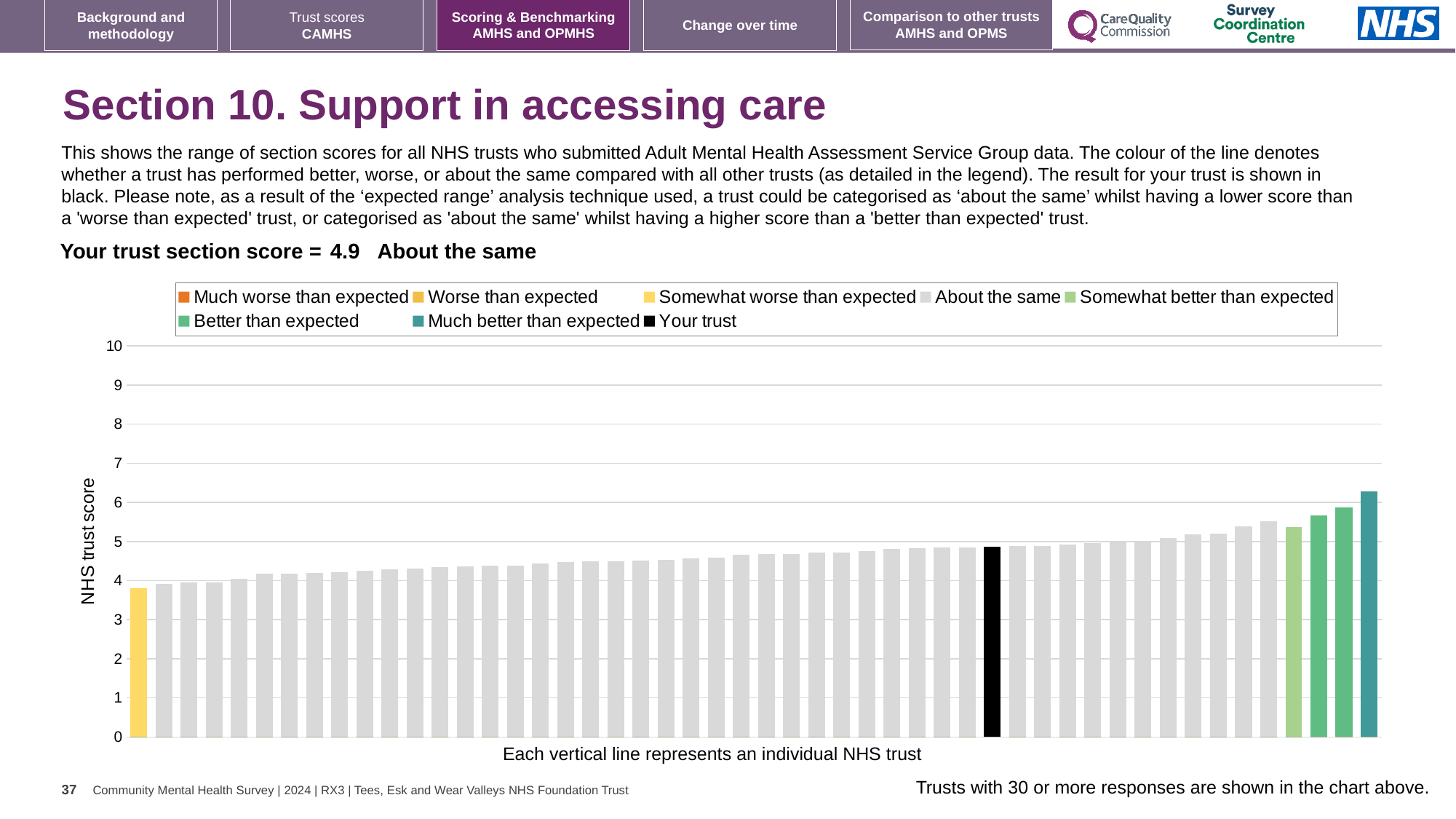
What kind of chart is shown on the slide? bar chart What is the label on the vertical axis of the chart? NHS trust score What is the section score for your trust shown on the slide? 4.9 Is the value of the black bar (your trust) greater or less than 4? greater Is the value of the shortest bar (leftmost) greater or less than 5? less Which legend category does the rightmost (teal) bar belong to? Much better than expected Which category does your trust's section score of 4.9 fall into, according to the slide? About the same How many entries does the chart legend list? 8 How many bars in the chart are coloured black? 1 Is your trust's bar higher or lower than the rightmost bar in the chart? lower Is the value of the tallest bar (rightmost) greater or less than 6? greater Do the bar values rise or fall from left to right along the x axis? rise